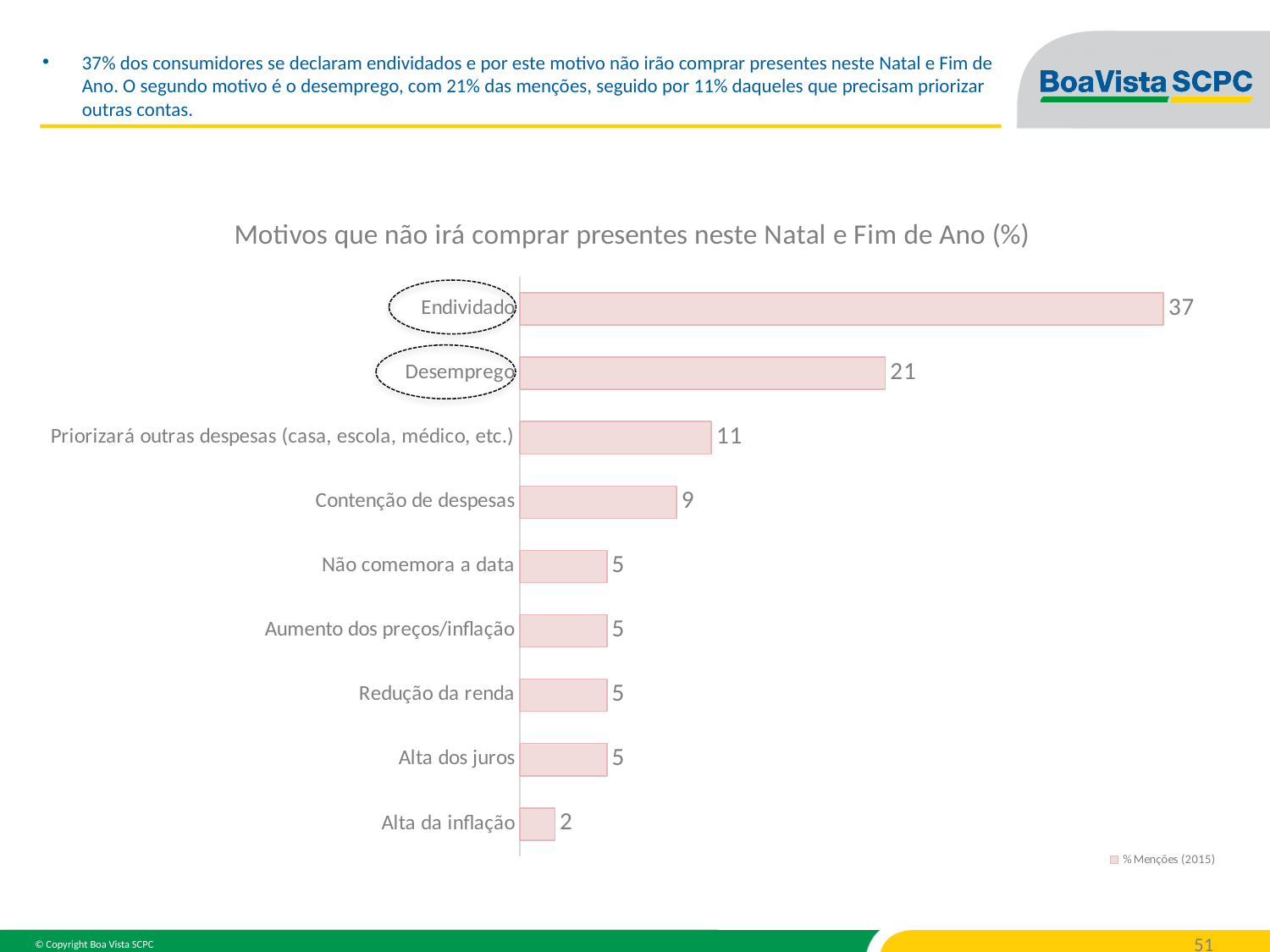
What is the value for Alta da inflação? 2 What is the difference between the values for Endividado and Desemprego? 16 Which category has the lowest value? Alta da inflação Which category has the highest value? Endividado How many categories are shown in the chart? 9 What is the value for Desemprego? 21 What is the value for Contenção de despesas? 9 What is the title of the chart? Motivos que não irá comprar presentes neste Natal e Fim de Ano (%) What kind of chart is shown on the slide? Bar chart What is the value for Endividado? 37 What is the value for Priorizará outras despesas (casa, escola, médico, etc.)? 11 Which is larger, the value for Contenção de despesas or the value for Não comemora a data? Contenção de despesas